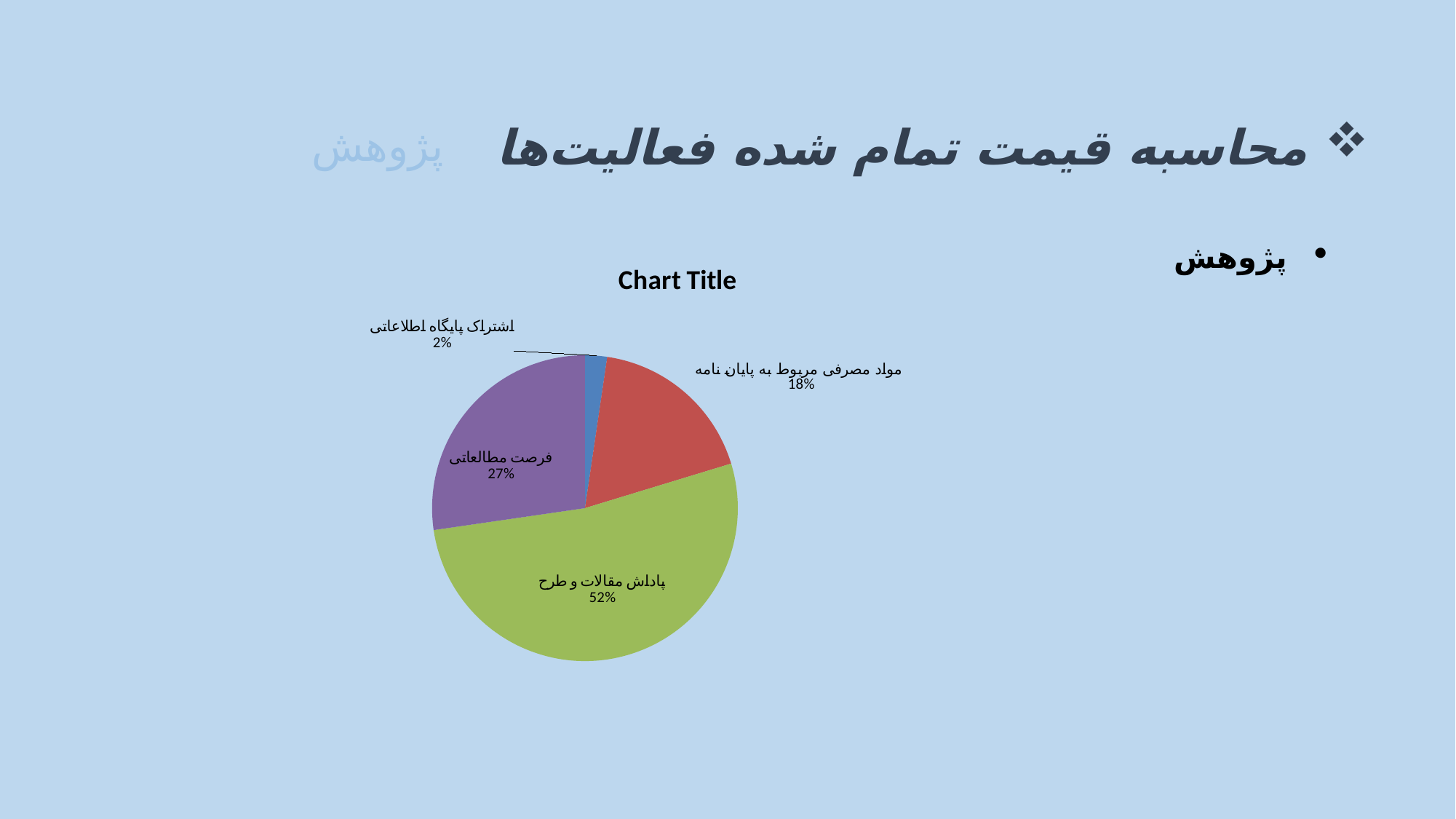
Which category has the largest slice of the pie? پاداش مقالات و طرح How many slices does the pie chart have? 4 What share of the pie is labelled فرصت مطالعاتی? 27% Which is larger, the slice for فرصت مطالعاتی or the slice for مواد مصرفی مربوط به پایان نامه? فرصت مطالعاتی What share of the pie is labelled اشتراک پایگاه اطلاعاتی? 2% What share of the pie is labelled مواد مصرفی مربوط به پایان نامه? 18% What colour is the slice for پاداش مقالات و طرح? green Which category has the smallest slice of the pie? اشتراک پایگاه اطلاعاتی What is the difference in percentage points between فرصت مطالعاتی and مواد مصرفی مربوط به پایان نامه? 9 What is the title of the chart? Chart Title What kind of chart is shown on the slide? pie chart